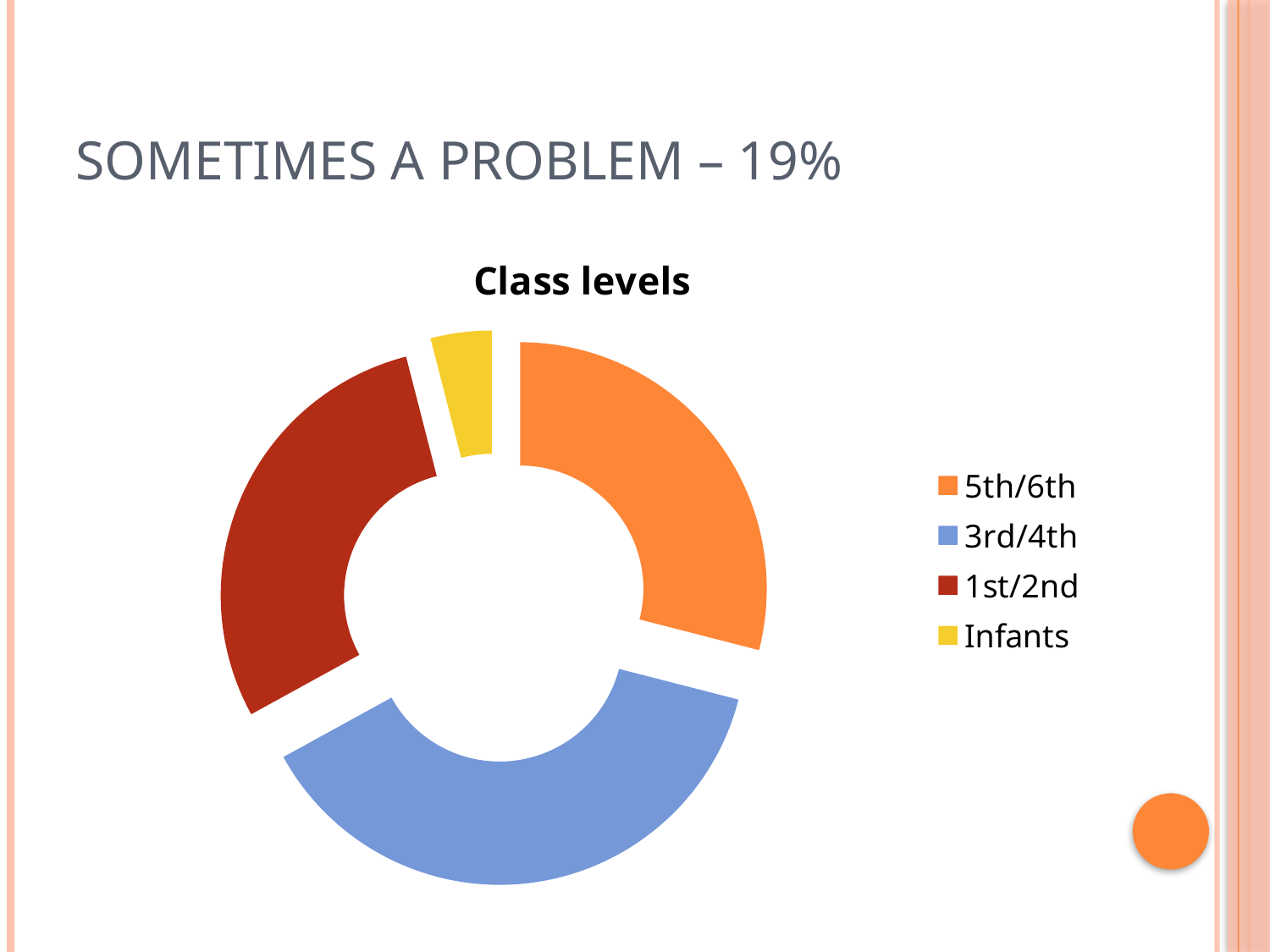
What colour represents Infants in the Class levels chart? yellow What is the title of the chart on the slide? Class levels What kind of chart is shown on the slide? doughnut chart Which is larger in the Class levels chart, the share for Infants or the share for 5th/6th? 5th/6th Which is larger in the Class levels chart, the share for 3rd/4th or the share for Infants? 3rd/4th Which category has the smallest share in the Class levels chart? Infants Which is larger in the Class levels chart, the share for 1st/2nd or the share for Infants? 1st/2nd How many categories does the Class levels chart show? 4 How many entries does the legend of the Class levels chart list? 4